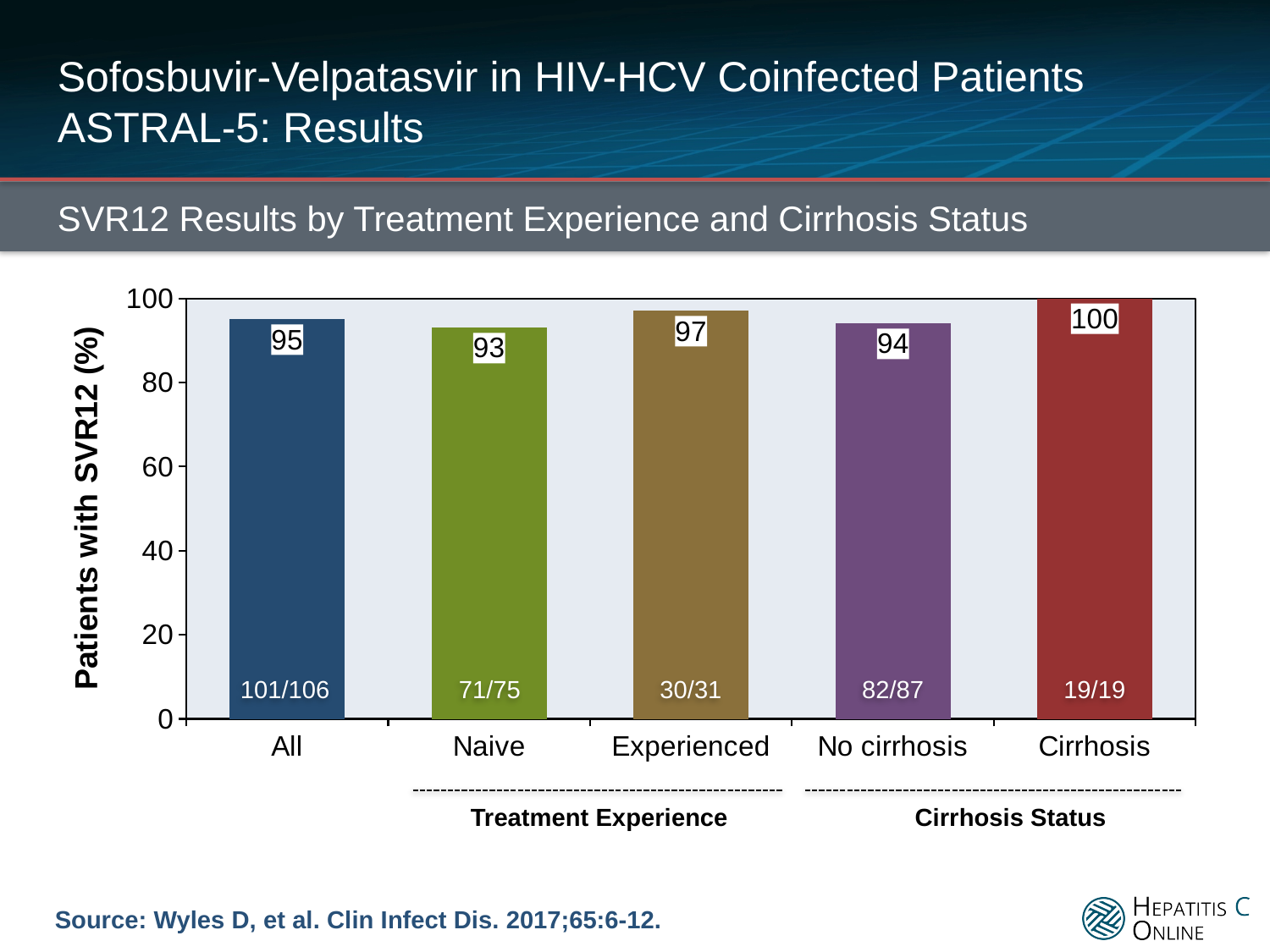
What is the SVR12 rate (%) for the All group? 95 What is the SVR12 rate (%) for patients with cirrhosis? 100 How many categories are shown on the x axis? 5 What is the SVR12 rate (%) for treatment-naive patients? 93 Which category has the highest SVR12 rate? Cirrhosis What is the difference in SVR12 rate between the Cirrhosis and Naive groups? 7 What fraction of patients is shown on the No cirrhosis bar? 82/87 Which has a higher SVR12 rate, Experienced or No cirrhosis? Experienced What fraction of patients is shown on the Experienced bar? 30/31 What kind of chart is shown on the slide? Bar chart What is the label of the y axis? Patients with SVR12 (%) Which category has the lowest SVR12 rate? Naive